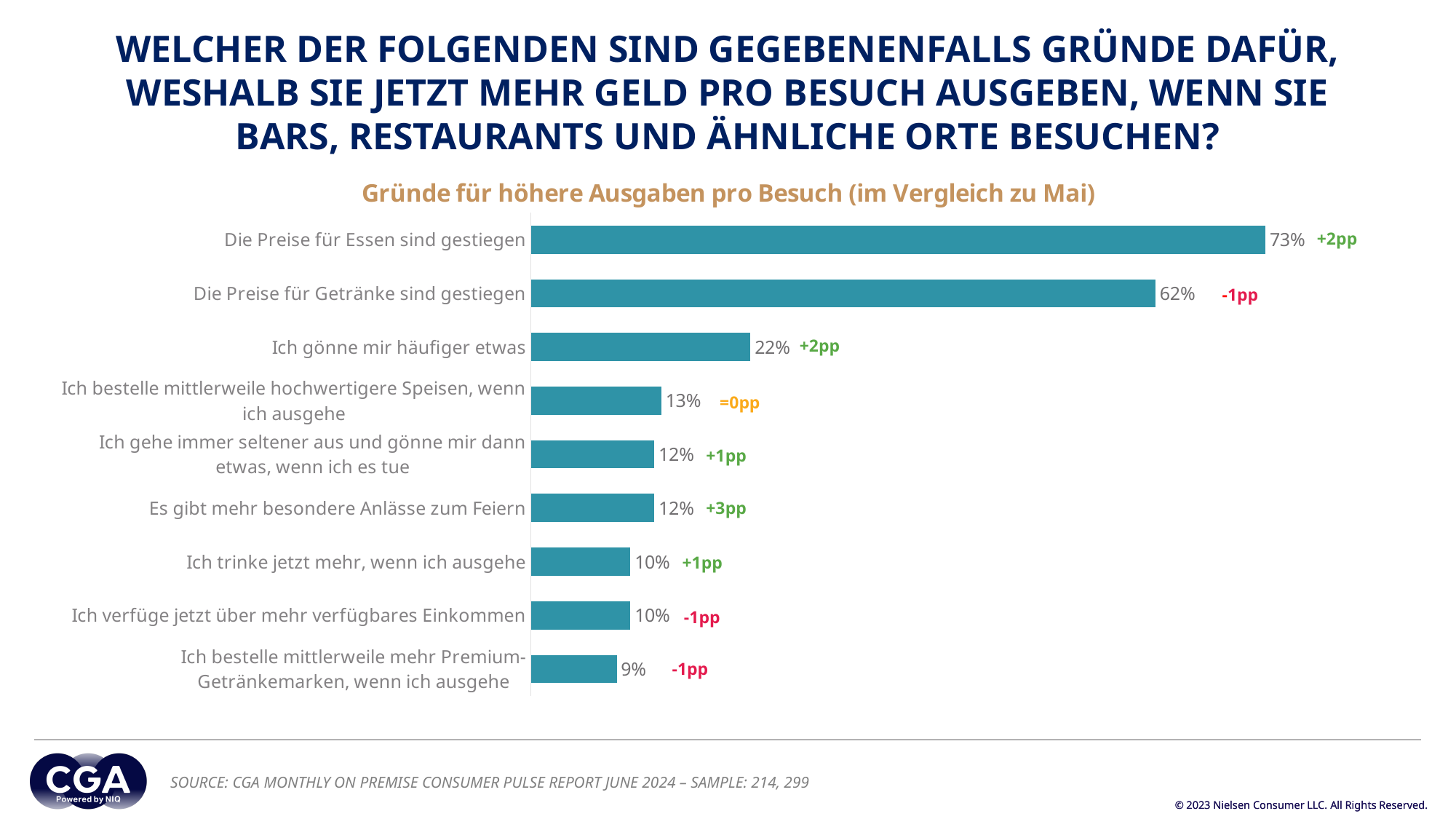
What is the change in percentage points shown next to "Die Preise für Getränke sind gestiegen"? -1pp How many categories are shown in the chart? 9 What kind of chart is shown on the slide? Bar chart What is the value for "Die Preise für Essen sind gestiegen"? 73% What is the change in percentage points shown next to "Es gibt mehr besondere Anlässe zum Feiern"? +3pp What is the value for "Ich gönne mir häufiger etwas"? 22% Which is larger: the value for "Ich gönne mir häufiger etwas" or the value for "Ich bestelle mittlerweile hochwertigere Speisen, wenn ich ausgehe"? Ich gönne mir häufiger etwas What is the title of the chart? Gründe für höhere Ausgaben pro Besuch (im Vergleich zu Mai) What is the difference between the values for "Die Preise für Essen sind gestiegen" and "Die Preise für Getränke sind gestiegen"? 11% Which category has the highest value? Die Preise für Essen sind gestiegen What is the value for "Ich bestelle mittlerweile mehr Premium-Getränkemarken, wenn ich ausgehe"? 9% Which category has the lowest value? Ich bestelle mittlerweile mehr Premium-Getränkemarken, wenn ich ausgehe